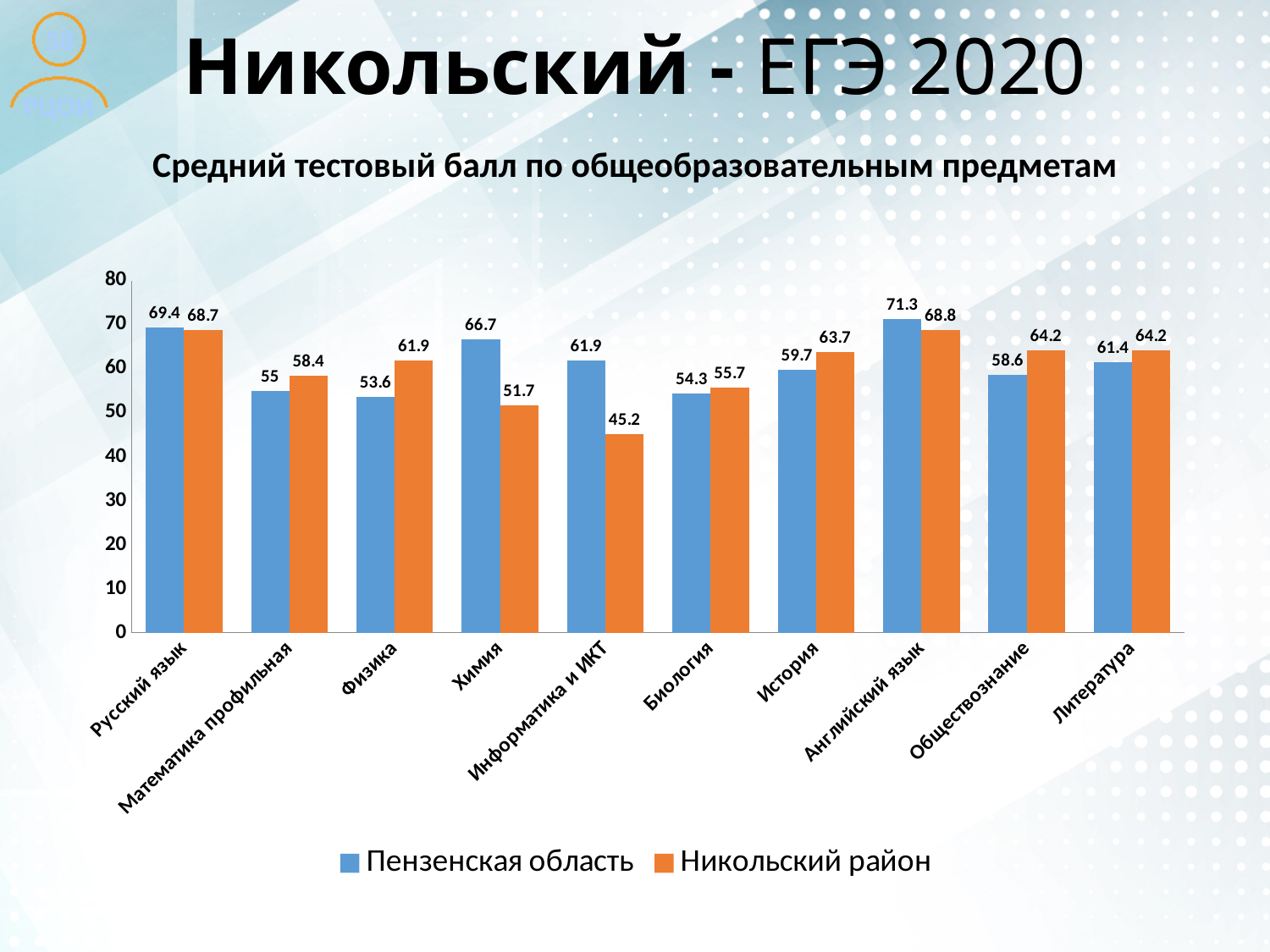
Which is larger in Физика: Пензенская область or Никольский район? Никольский район How many series does the legend list? 2 What is the value for Никольский район in Обществознание? 64.2 What is the value for Никольский район in Информатика и ИКТ? 45.2 What is the difference between Пензенская область and Никольский район in Химия? 15 Which subject has the lowest value for Никольский район? Информатика и ИКТ What is the value for Пензенская область in Русский язык? 69.4 Is the value for Никольский район in Информатика и ИКТ greater or less than 50? less Which subject has the highest value for Пензенская область? Английский язык What kind of chart is shown on the slide? bar chart What is the subtitle of the chart? Средний тестовый балл по общеобразовательным предметам How many subjects are shown on the x axis? 10